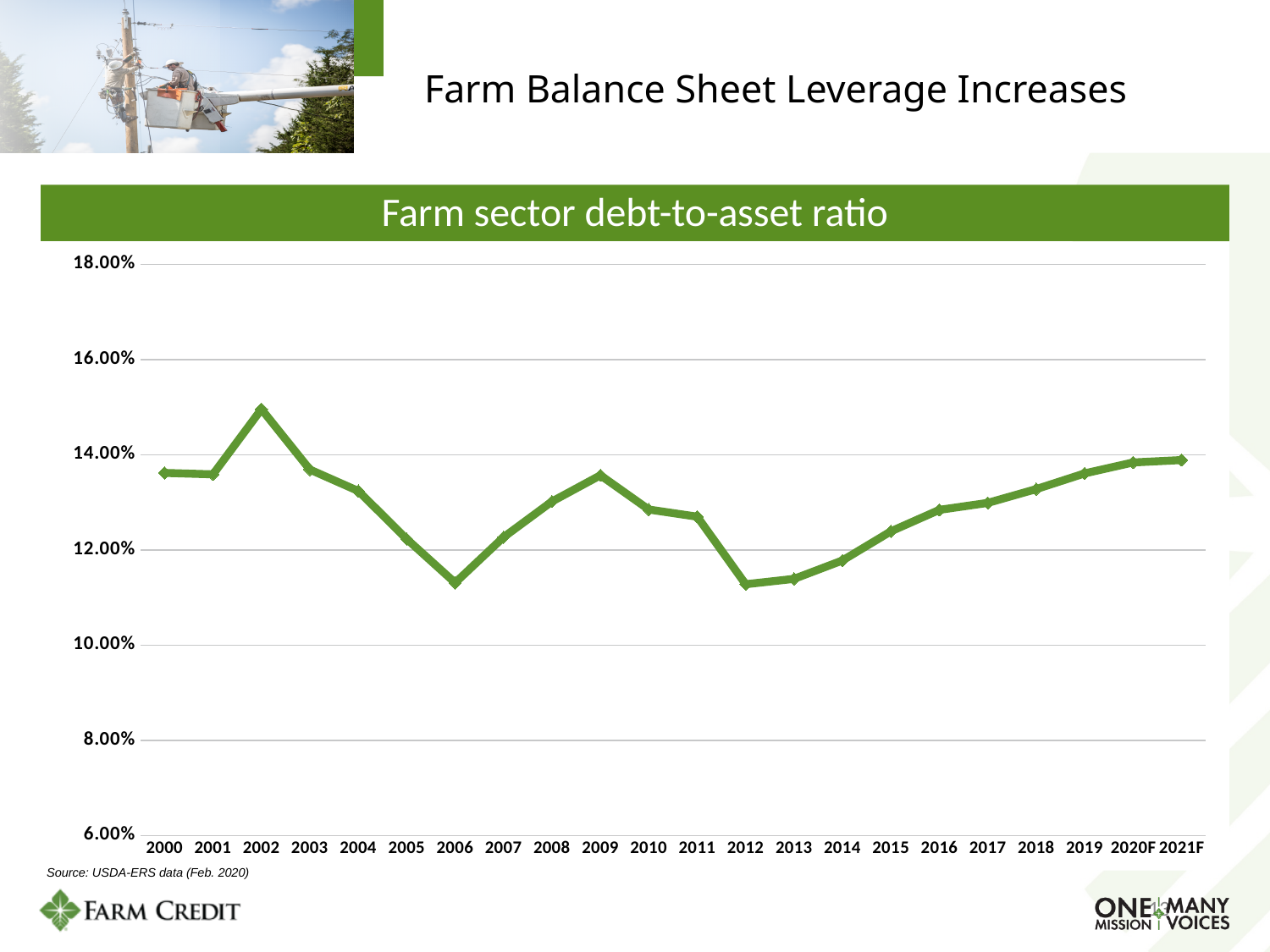
Which year has the highest debt-to-asset ratio? 2002 Which is larger, the value for 2009 or the value for 2012? 2009 What is the title of the chart? Farm sector debt-to-asset ratio What kind of chart is shown on the slide? Line chart Does the debt-to-asset ratio rise or fall from 2012 to 2021F? Rise Is the value for 2012 greater or less than 12.00%? less Is the value for 2006 greater or less than 12.00%? less Is the value for 2002 greater or less than 14.00%? greater What is the source cited below the chart? USDA-ERS data (Feb. 2020) How many years (data points) are plotted along the x axis? 22 Which is larger, the value for 2002 or the value for 2021F? 2002